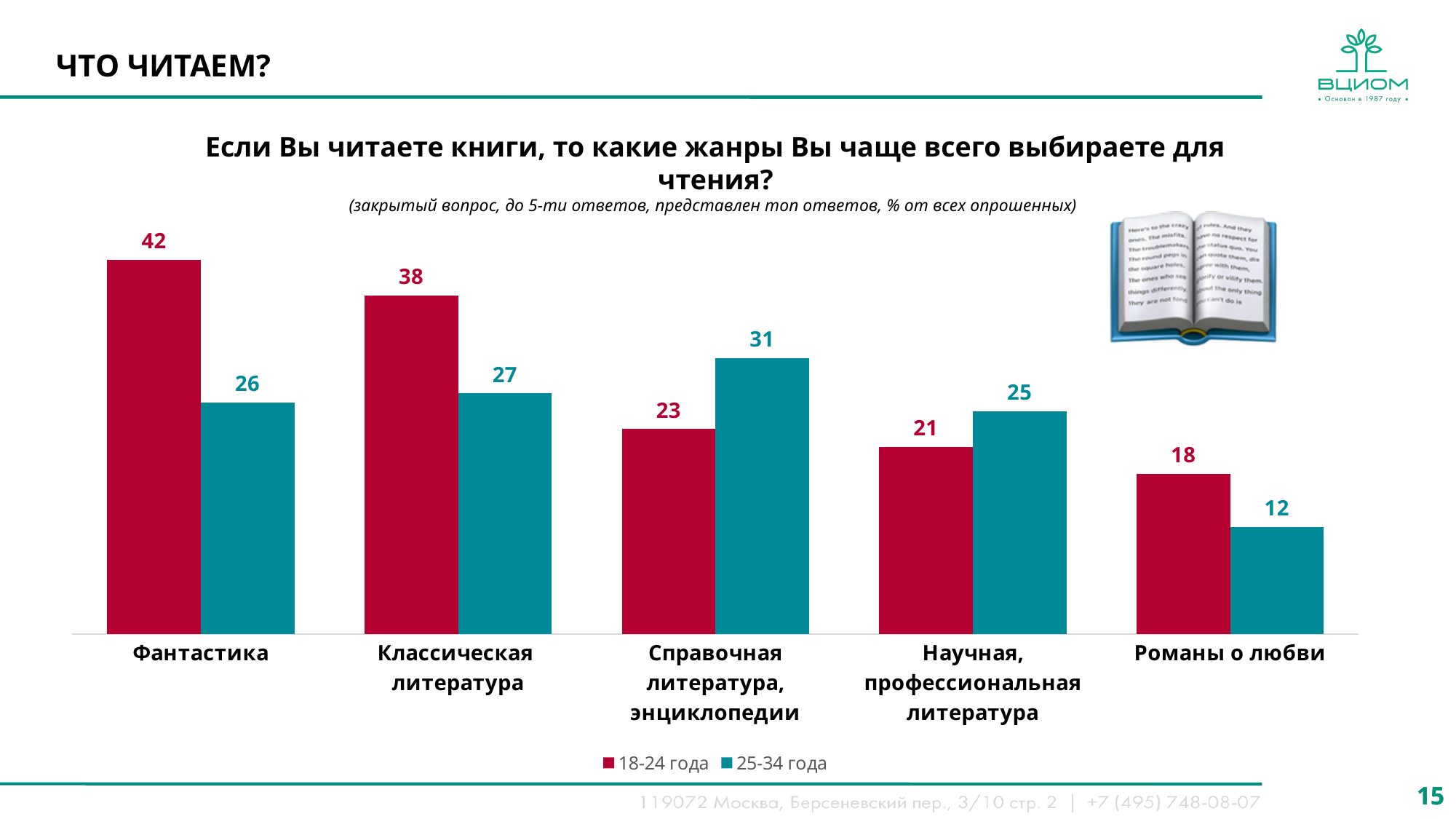
Which category has the lowest value in the 25-34 года series? Романы о любви What is the value for Фантастика in the 18-24 года series? 42 What is the difference between the 18-24 года and 25-34 года values for Фантастика? 16 What is the value for Справочная литература, энциклопедии in the 25-34 года series? 31 What is the value for Романы о любви in the 25-34 года series? 12 For Научная, профессиональная литература, which series has the larger value: 18-24 года or 25-34 года? 25-34 года What kind of chart is shown on the slide? Bar chart What is the difference between the 25-34 года and 18-24 года values for Справочная литература, энциклопедии? 8 Which category has the highest value in the 18-24 года series? Фантастика Which colour represents the 25-34 года series? Teal How many categories are shown on the x axis? 5 How many series does the legend list? 2